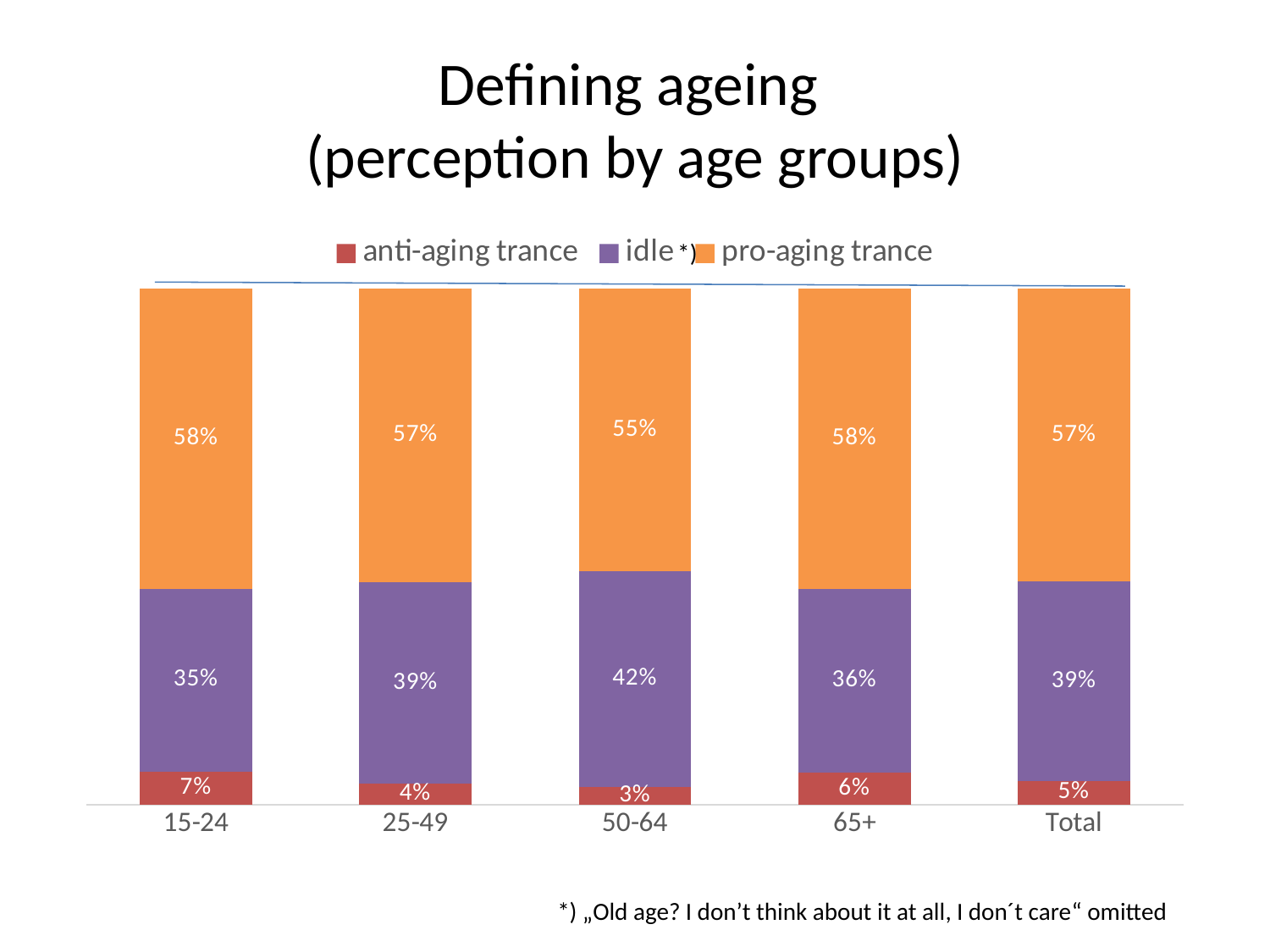
What is the title of the chart? Defining ageing (perception by age groups) Which age group has the highest value for 'idle'? 50-64 What is the total of the stacked bar for the 25-49 age group? 100% What is the difference between the 'idle' values for 50-64 and 15-24? 7% What is the value for 'anti-aging trance' in the 15-24 age group? 7% How many series does the legend list? 3 What kind of chart is shown on the slide? stacked bar chart Which is larger, the 'anti-aging trance' value for 65+ or for 25-49? 65+ Which age group has the lowest value for 'anti-aging trance'? 50-64 What is the value for 'pro-aging trance' in the Total category? 57% How many age-group categories are shown on the x axis? 5 What is the value for 'idle' in the 50-64 age group? 42%